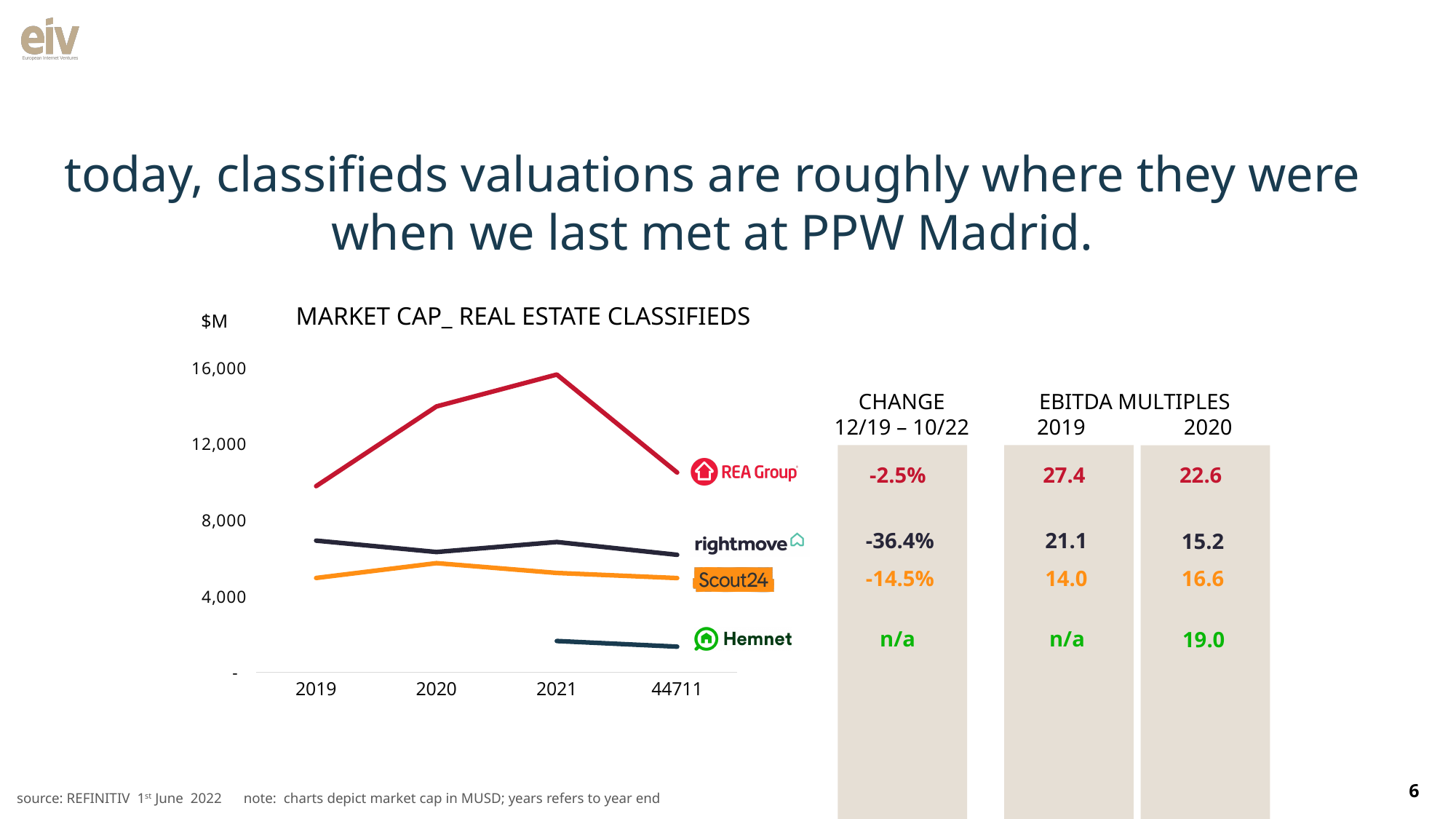
Is the market cap of rightmove in 2019 greater or less than 8,000? less How many points are shown along the x axis of the market cap chart? 4 Does the REA Group line rise or fall between 2021 and the last x-axis point (44711)? fall What unit is shown at the top of the y axis of the market cap chart? $M In 2019, which has the larger market cap on the chart, rightmove or Scout24? rightmove Is the market cap of REA Group in 2019 greater or less than 12,000? less Is the market cap of Scout24 in 2020 greater or less than 4,000? greater How many companies (series) are plotted on the market cap chart? 4 Which company has the lowest market cap at the last x-axis point (44711) on the chart? Hemnet Which company has the highest market cap in 2021 on the chart? REA Group What kind of chart is the MARKET CAP_ REAL ESTATE CLASSIFIEDS chart? line chart